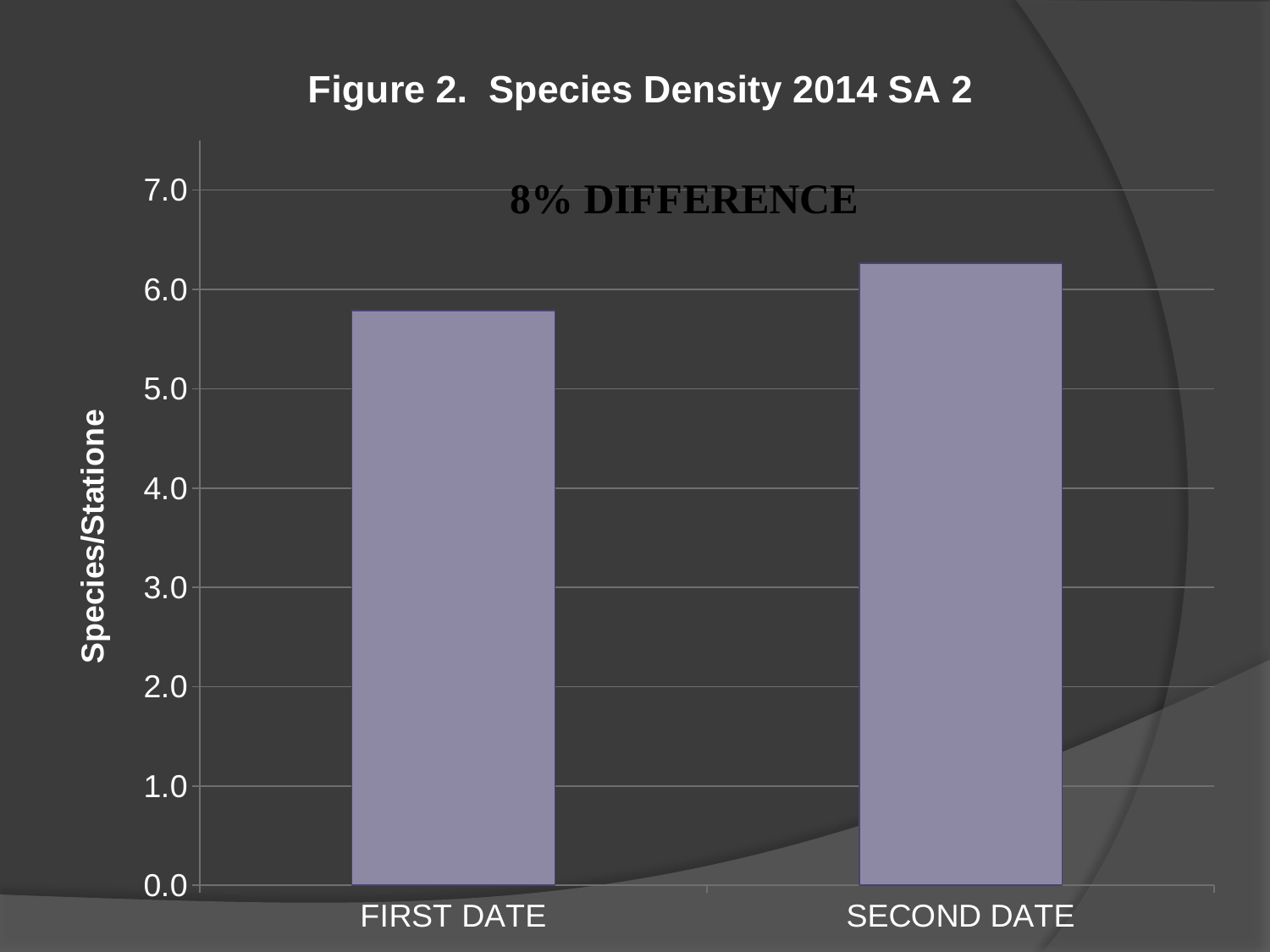
Is the value for SECOND DATE greater or less than 7.0? less Which category has the highest value? SECOND DATE Is the value for SECOND DATE greater or less than 6.0? greater How many categories are plotted on the x axis? 2 What type of chart is shown on the slide? bar chart Which category has the higher species density, FIRST DATE or SECOND DATE? SECOND DATE What is the label on the y axis? Species/Statione Which category has the lowest value? FIRST DATE What is the title of the chart? Figure 2. Species Density 2014 SA 2 Do the values rise or fall from FIRST DATE to SECOND DATE? rise Is the value for FIRST DATE greater or less than 5.0? greater